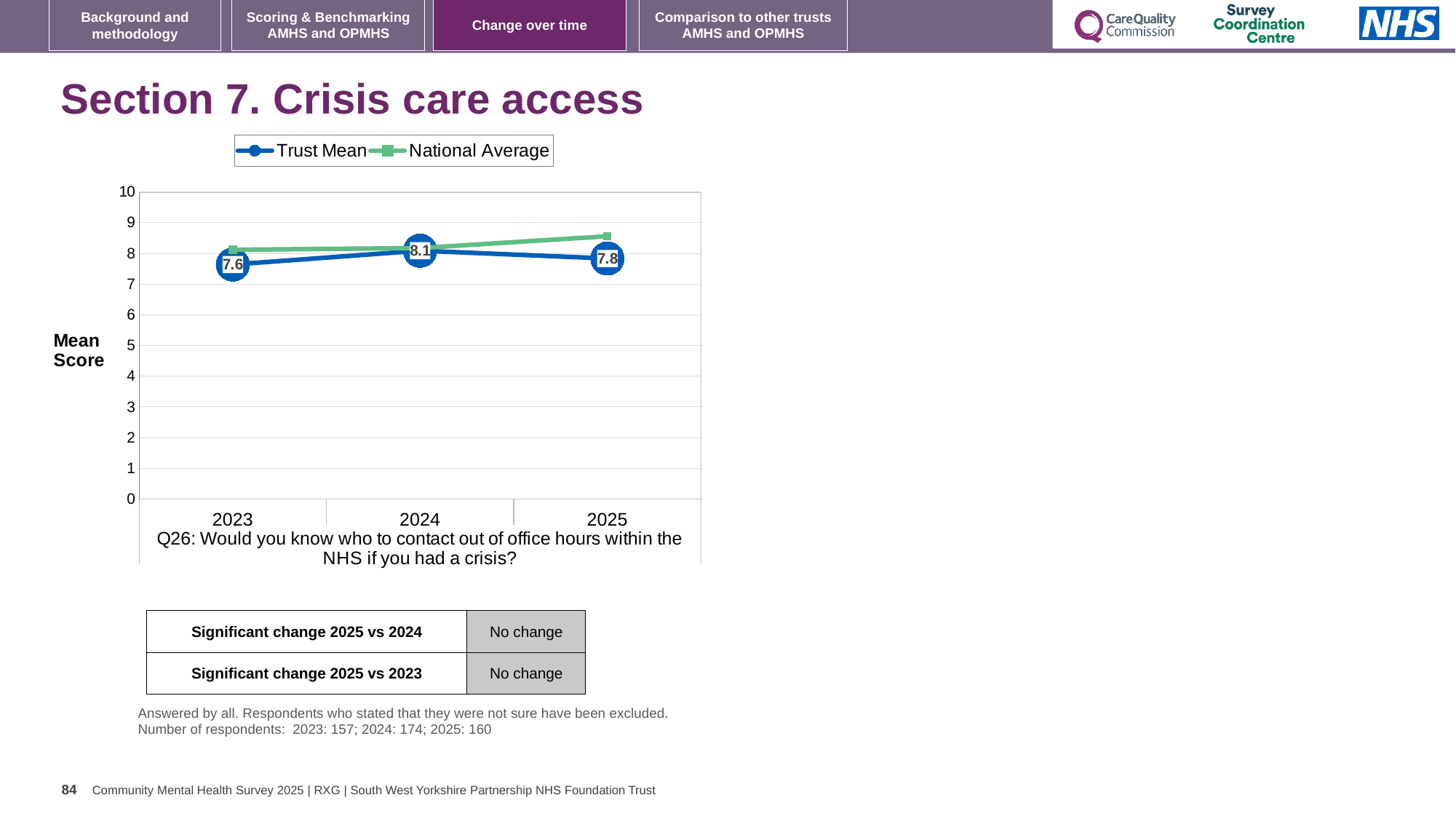
What kind of chart is shown? line chart What is the Trust Mean score for 2023? 7.6 What is the Trust Mean score for 2024? 8.1 How many series does the legend list? 2 In which year is the Trust Mean lowest? 2023 What is the label of the y axis? Mean Score How many years are shown on the x axis? 3 What is the difference between the Trust Mean in 2024 and in 2023? 0.5 Which is larger, the Trust Mean in 2025 or in 2023? 2025 In which year is the Trust Mean highest? 2024 Is the National Average for 2025 greater or less than 8? greater What is the Trust Mean score for 2025? 7.8